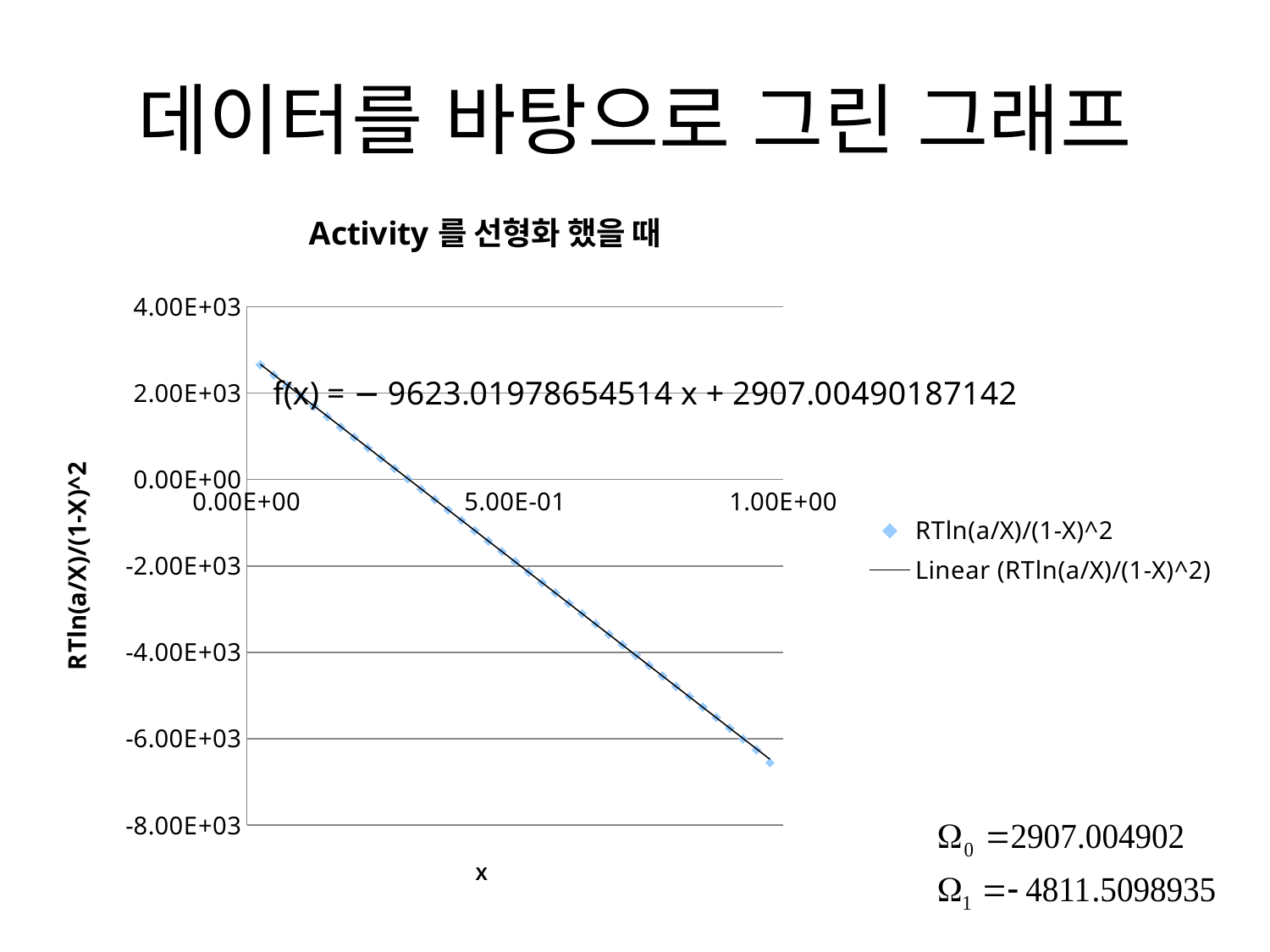
What is the label of the y axis? RTln(a/X)/(1-X)^2 Which has the larger plotted value: the point at x = 0.00E+00 or the point at x = 5.00E-01? The point at x = 0.00E+00 What is the highest tick value shown on the y axis? 4.00E+03 What is the title of the chart? Activity 를 선형화 했을 때 Do the plotted values rise or fall as x increases? Fall How many entries does the chart legend list? 2 What is the slope of the trendline shown on the chart? − 9623.01978654514 What kind of chart is shown on the slide? Scatter chart with a linear trendline What is the trendline equation displayed on the chart? f(x) = − 9623.01978654514 x + 2907.00490187142 Is the plotted value at x = 0.00E+00 greater or less than 2.00E+03? greater Is the plotted value at the largest x (near 1.00E+00) greater or less than -6.00E+03? less What is the y-intercept of the trendline shown on the chart? 2907.00490187142